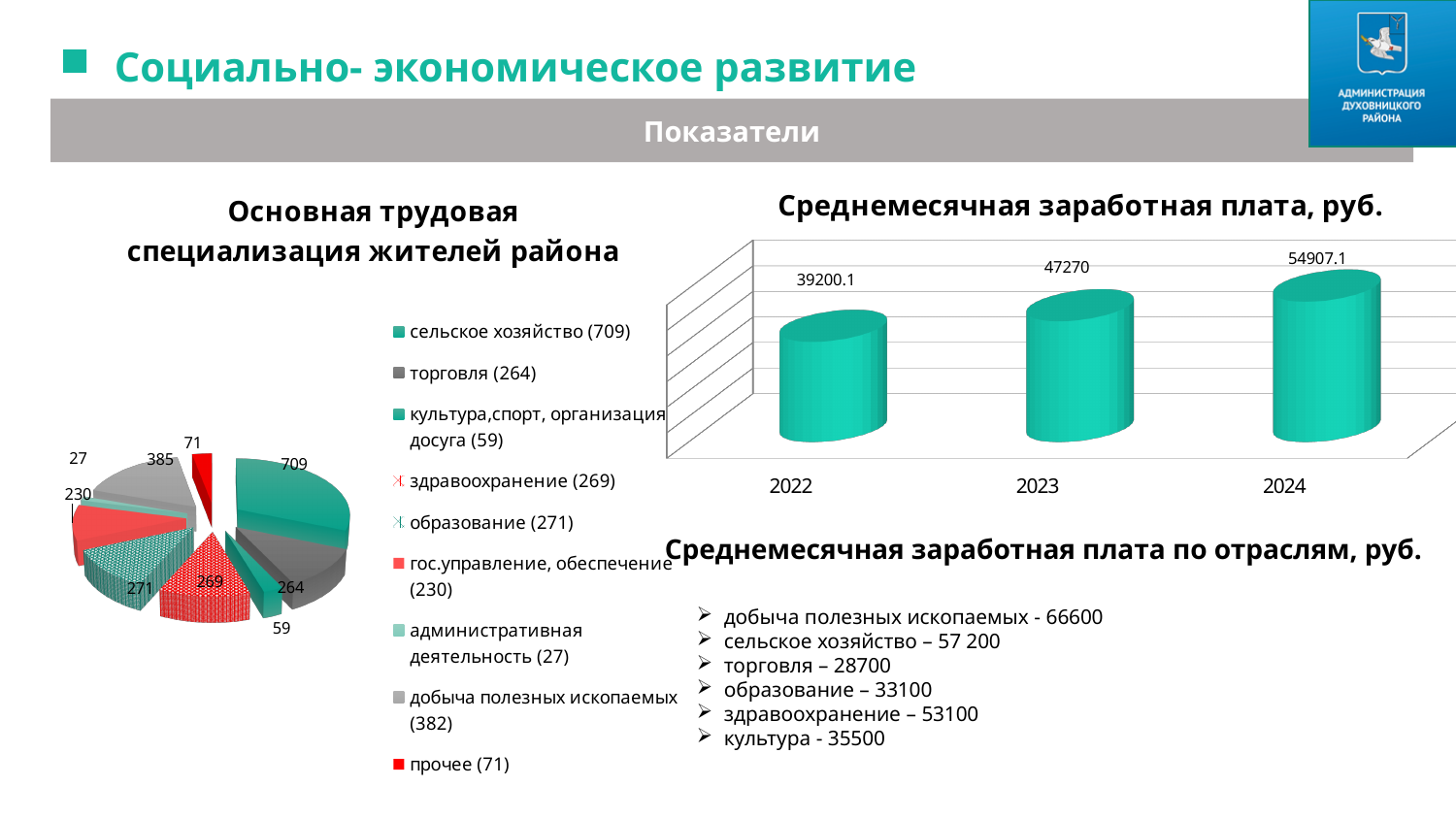
In the pie chart titled "Основная трудовая специализация жителей района", which is larger: торговля or образование? образование In the pie chart titled "Основная трудовая специализация жителей района", what is the value for сельское хозяйство? 709 What kind of chart is the one titled "Среднемесячная заработная плата, руб."? bar chart In the chart titled "Среднемесячная заработная плата, руб.", what is the value for 2022? 39200.1 How many entries does the legend of the pie chart titled "Основная трудовая специализация жителей района" list? 9 In the pie chart titled "Основная трудовая специализация жителей района", which category has the smallest value? административная деятельность In the chart titled "Среднемесячная заработная плата, руб.", how many years are shown? 3 In the chart titled "Среднемесячная заработная плата, руб.", what is the value for 2024? 54907.1 In the chart titled "Среднемесячная заработная плата, руб.", what is the value for 2023? 47270 In the chart titled "Среднемесячная заработная плата, руб.", do the values rise or fall from 2022 to 2024? rise What kind of chart is the one titled "Основная трудовая специализация жителей района"? pie chart In the chart titled "Среднемесячная заработная плата, руб.", which year has the highest value? 2024